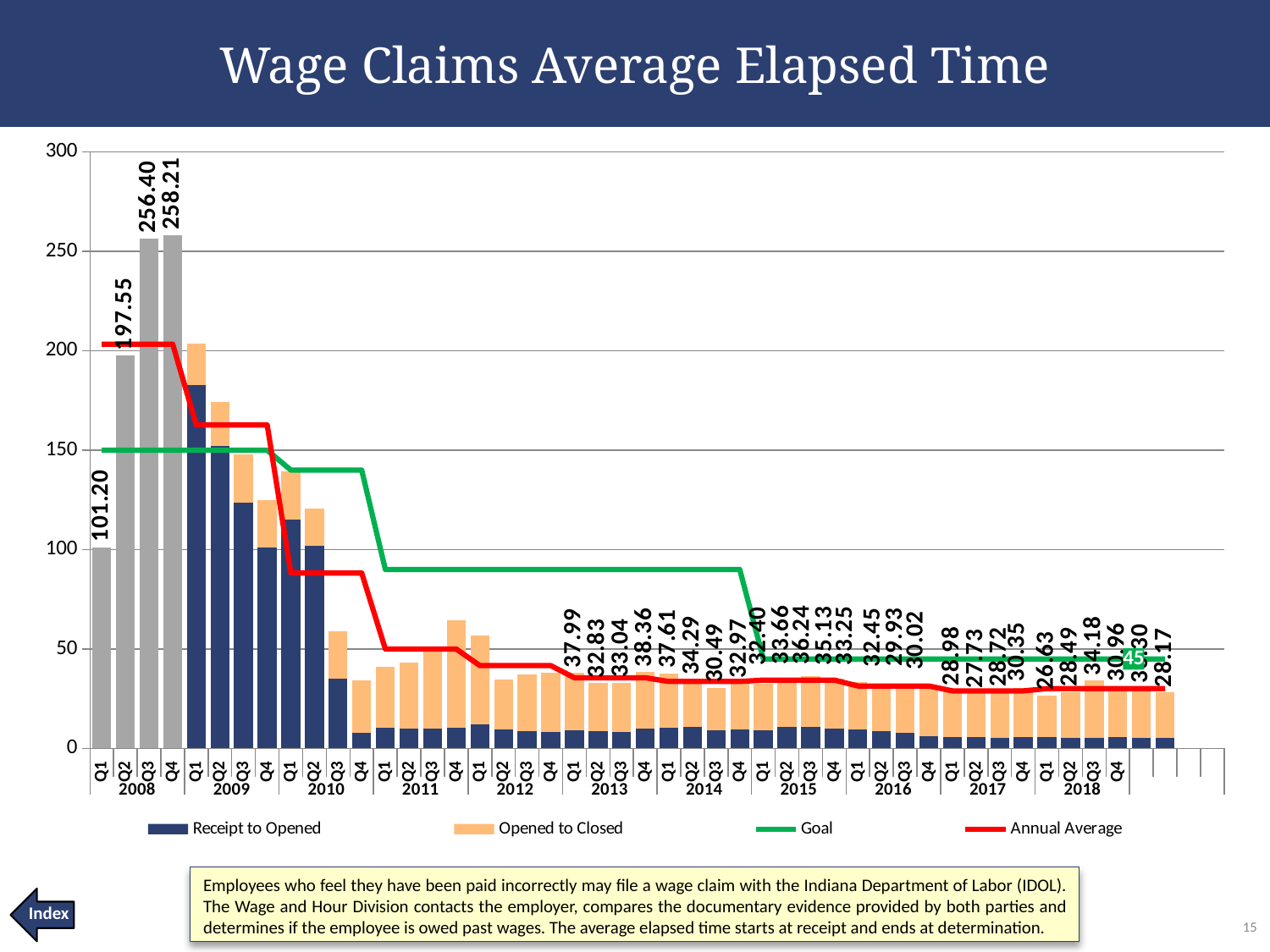
What is the value labeled for Q1 2013? 37.99 What is the difference between the Q4 2008 value and the Q3 2008 value? 1.81 What is the average elapsed time value for Q1 2008? 101.20 Which quarter has the highest average elapsed time? Q4 2008 How many series does the legend list? 4 What is the value labeled for Q4 2008? 258.21 Do the average elapsed time values generally rise or fall from 2008 to 2018? fall Which is larger, the value for Q2 2008 or the value for Q3 2008? Q3 2008 What kind of chart is shown on the slide? combination bar and line chart Is the total value for Q2 2009 greater or less than 200? less What is the Goal value shown for 2008? 150 What is the value labeled for Q2 2017? 27.73